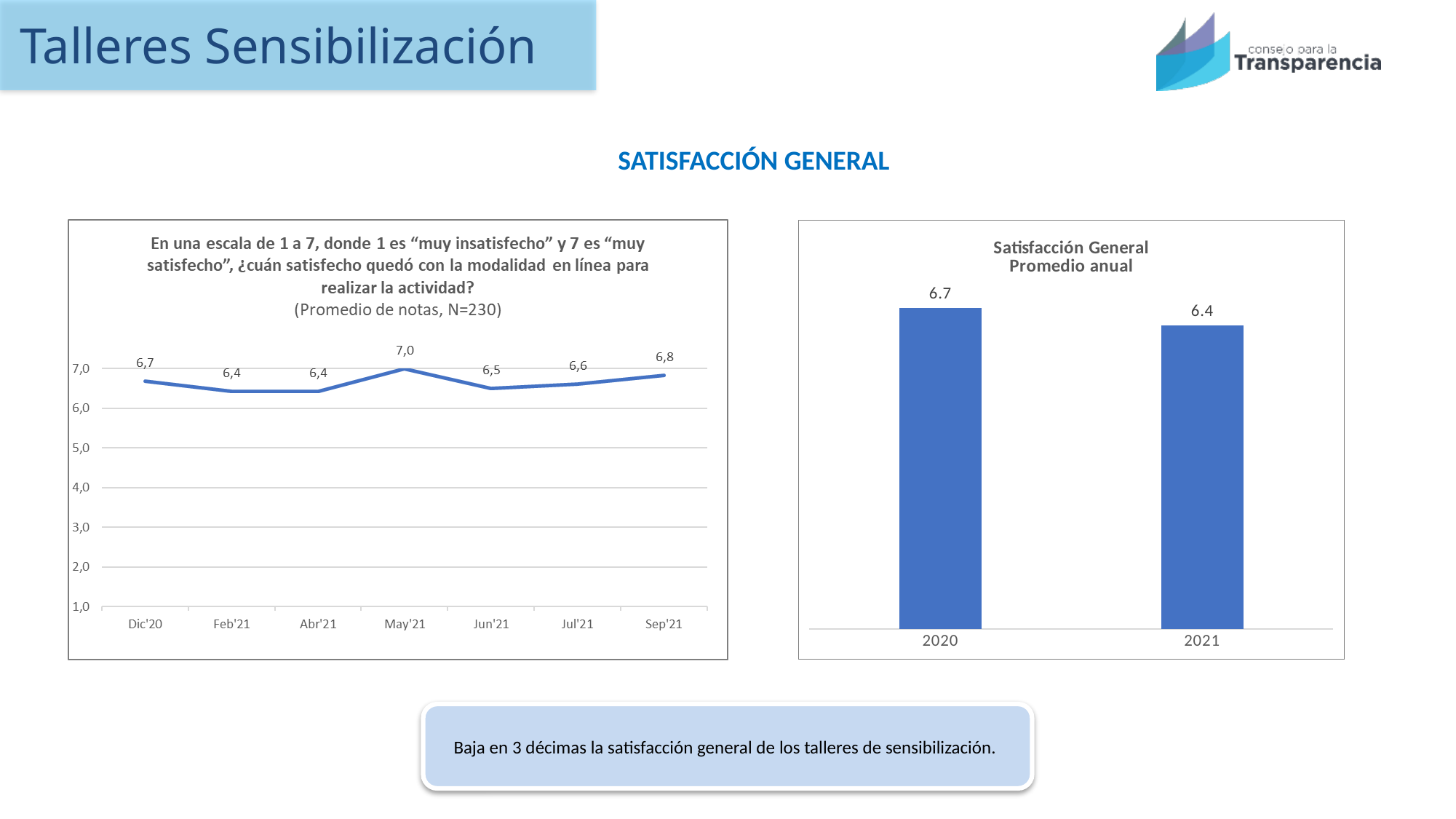
In the line chart on the left, what is the difference between the values for May'21 and Feb'21? 0,6 In the 'Satisfacción General Promedio anual' chart on the right, what is the value for 2020? 6.7 In the 'Satisfacción General Promedio anual' chart on the right, what is the difference between the 2020 and 2021 values? 0.3 In the line chart on the left, what is the value for Dic'20? 6,7 What kind of chart is the 'Satisfacción General Promedio anual' chart on the right? Bar chart In the line chart on the left, which is larger, the value for Sep'21 or the value for Jun'21? Sep'21 In the line chart on the left, what is the value for Jul'21? 6,6 In the 'Satisfacción General Promedio anual' chart on the right, what is the value for 2021? 6.4 In the line chart on the left, how many data points are plotted? 7 In the line chart on the left, which month has the highest value? May'21 In the line chart on the left, what is the value for May'21? 7,0 In the 'Satisfacción General Promedio anual' chart on the right, do the values rise or fall from 2020 to 2021? Fall